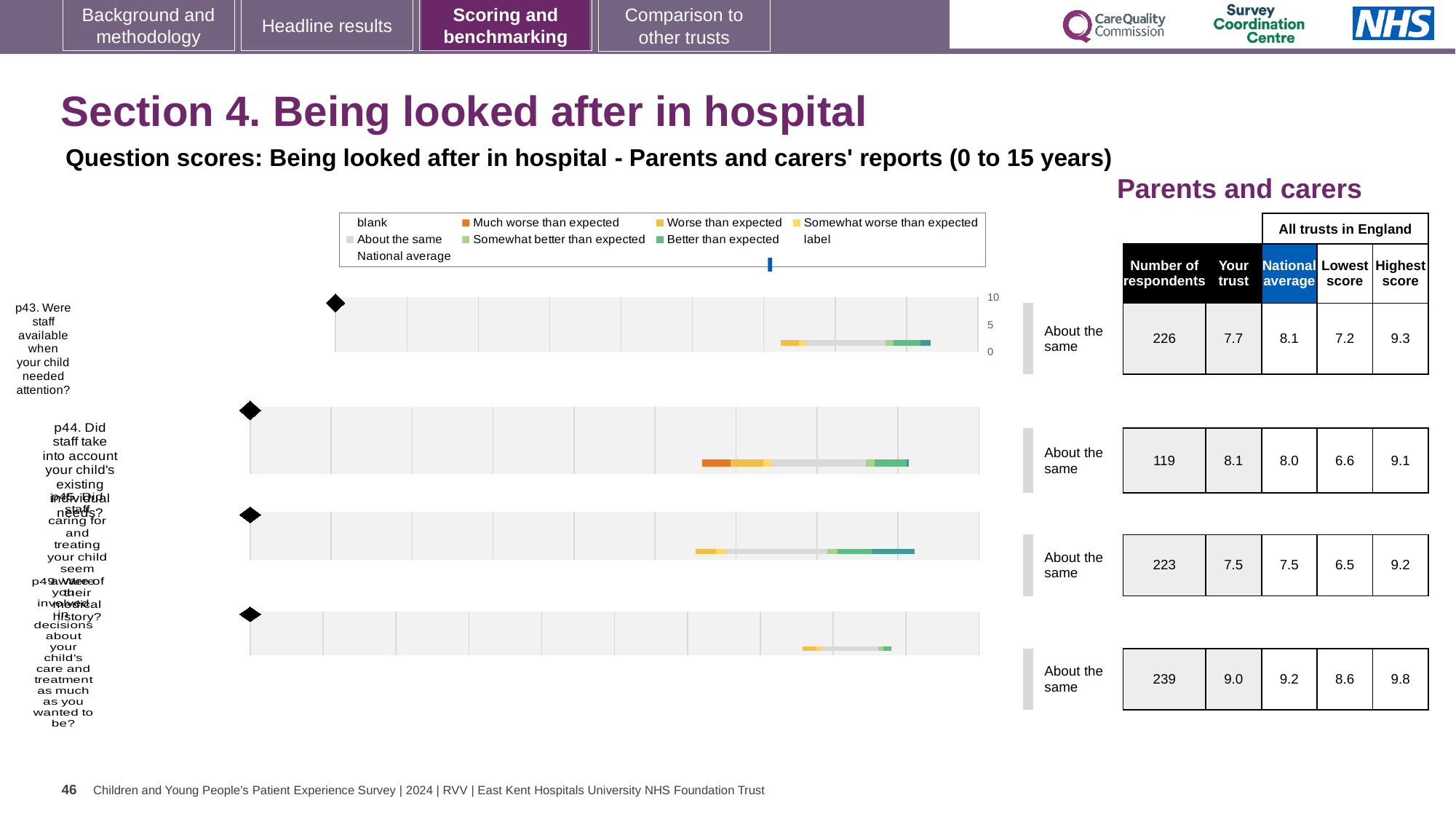
What benchmarking category is shown for all four questions? About the same For question p43, which is larger: the 'Your trust' score or the national average? National average For question p43 (Were staff available when your child needed attention?), what is the number of respondents? 226 Which chart row has the highest 'Your trust' score? The fourth (bottom) row, p49, with 9.0 For question p43, what is the national average score? 8.1 How many questions (chart rows) are shown on the slide? 4 What kind of chart is used to show the question scores on this slide? bar chart For question p43, what is the 'Your trust' score? 7.7 What is the subtitle describing the question scores shown on the slide? Question scores: Being looked after in hospital - Parents and carers' reports (0 to 15 years) Which chart row has the lowest 'Your trust' score? The third row, p45, with 7.5 For the fourth (bottom) chart row, what is the highest score among all trusts in England? 9.8 For question p43, what is the difference between the highest score and the lowest score across all trusts in England? 2.1